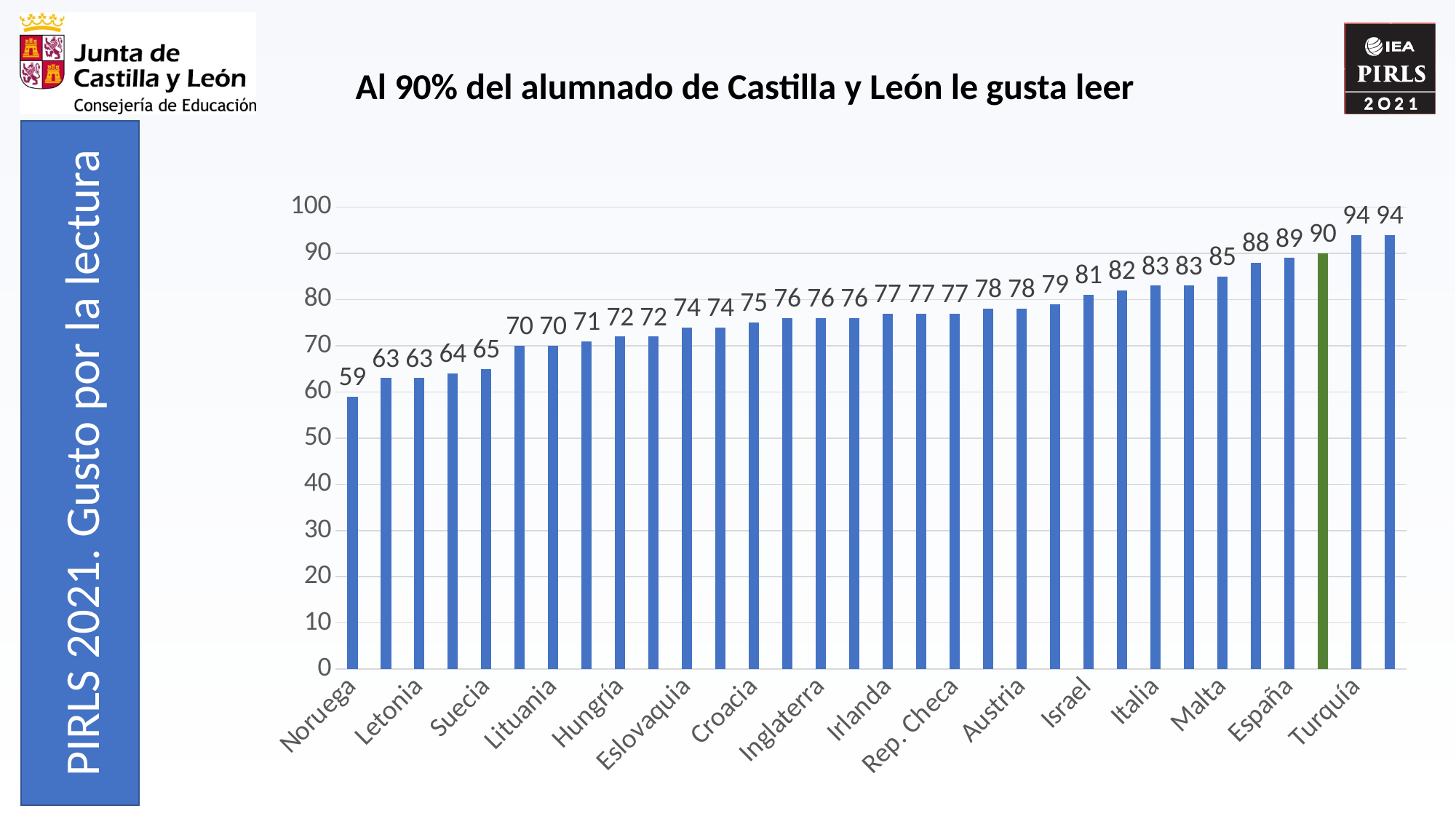
What type of chart is shown on the slide? bar chart Which is larger, the value for Turquía or the value for Noruega? Turquía Which labelled country has the lowest value in the chart? Noruega What is the title of the chart on the slide? Al 90% del alumnado de Castilla y León le gusta leer What is the difference between the highest value (94) and the lowest value (59) in the chart? 35 How many bars are plotted in the chart? 32 What is the difference between the green bar (90) and the value for Noruega (59)? 31 Do the values rise or fall from left to right along the x axis? rise What is the value of the green bar in the chart? 90 What is the value shown for Turquía? 94 What is the highest value shown in the chart? 94 What is the value shown for Noruega? 59